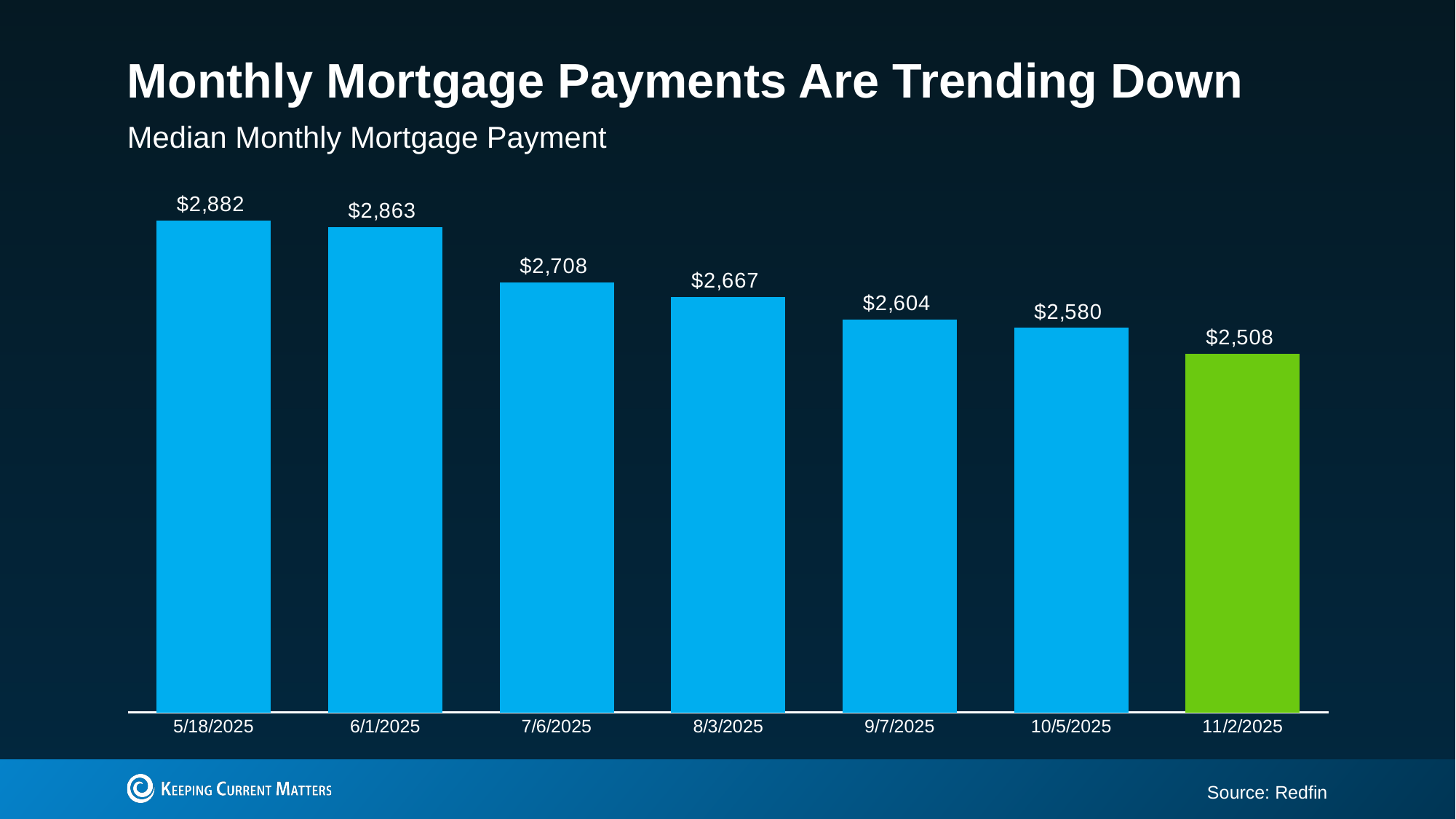
Do the median monthly mortgage payments rise or fall from 5/18/2025 to 11/2/2025? Fall What is the median monthly mortgage payment for 5/18/2025? $2,882 How many dates are shown on the chart? 7 What is the difference between the median monthly mortgage payment on 9/7/2025 and on 10/5/2025? $24 Which bar is coloured green rather than blue? 11/2/2025 What is the median monthly mortgage payment for 11/2/2025? $2,508 What is the difference between the median monthly mortgage payment on 5/18/2025 and on 11/2/2025? $374 Which is larger, the median monthly mortgage payment on 7/6/2025 or on 9/7/2025? 7/6/2025 What is the median monthly mortgage payment for 8/3/2025? $2,667 Which date has the lowest median monthly mortgage payment? 11/2/2025 What kind of chart is shown on the slide? Bar chart Which date has the highest median monthly mortgage payment? 5/18/2025